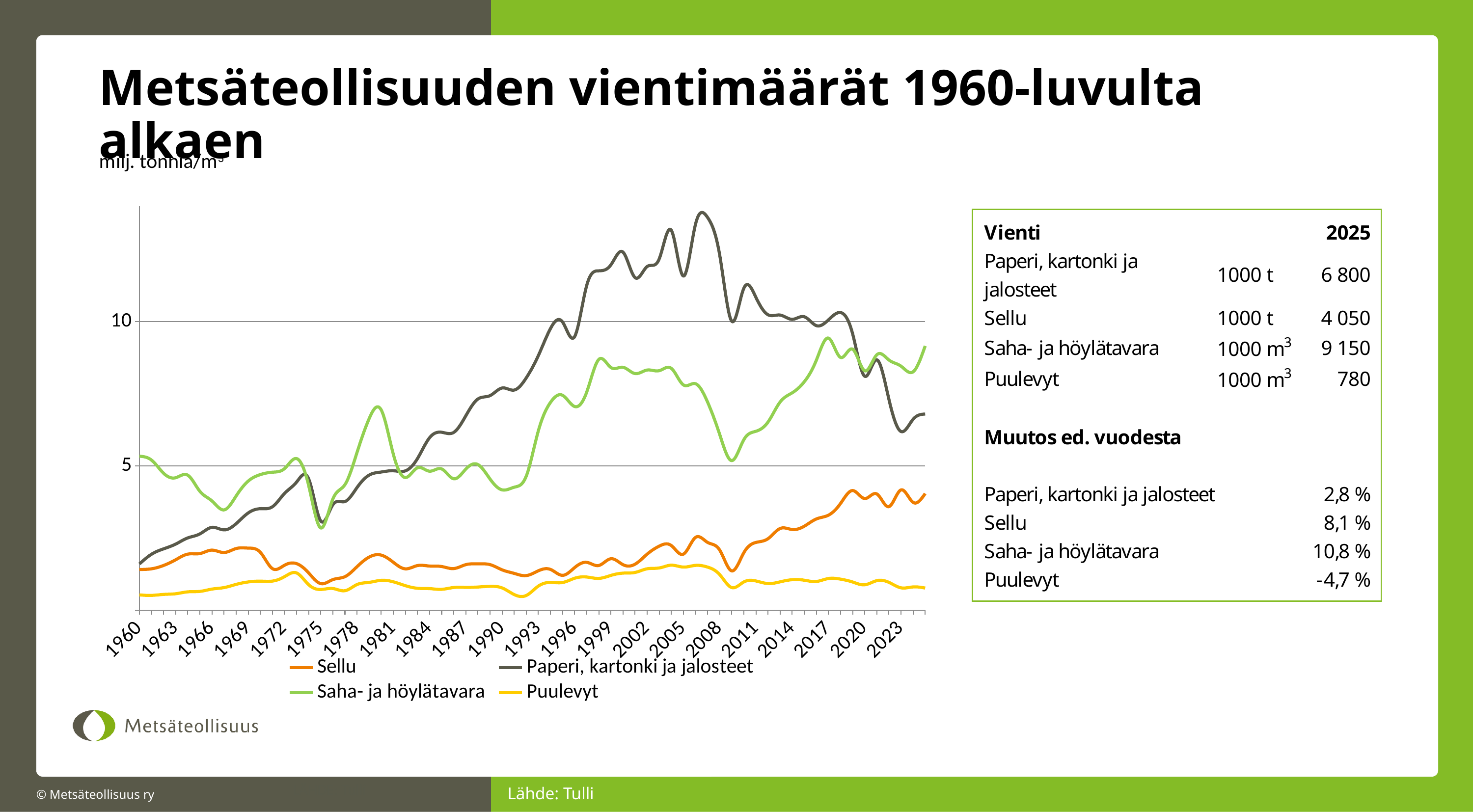
Is the value for Puulevyt in 2005 greater or less than 5? less What kind of chart is shown on the slide? line chart Is the value for Paperi, kartonki ja jalosteet in 2023 greater or less than 10? less Does the Sellu line rise or fall overall from 1960 to 2023? rise Is the value for Sellu in 1960 greater or less than 5? less Which series is plotted with the orange line? Sellu What unit label is shown above the chart's y axis? milj. tonnia/m³ Does the Paperi, kartonki ja jalosteet line rise or fall from 2008 to 2023? fall How many series does the chart legend list? 4 Which series has the lowest values across the whole period? Puulevyt Which series has the highest value around 2005? Paperi, kartonki ja jalosteet